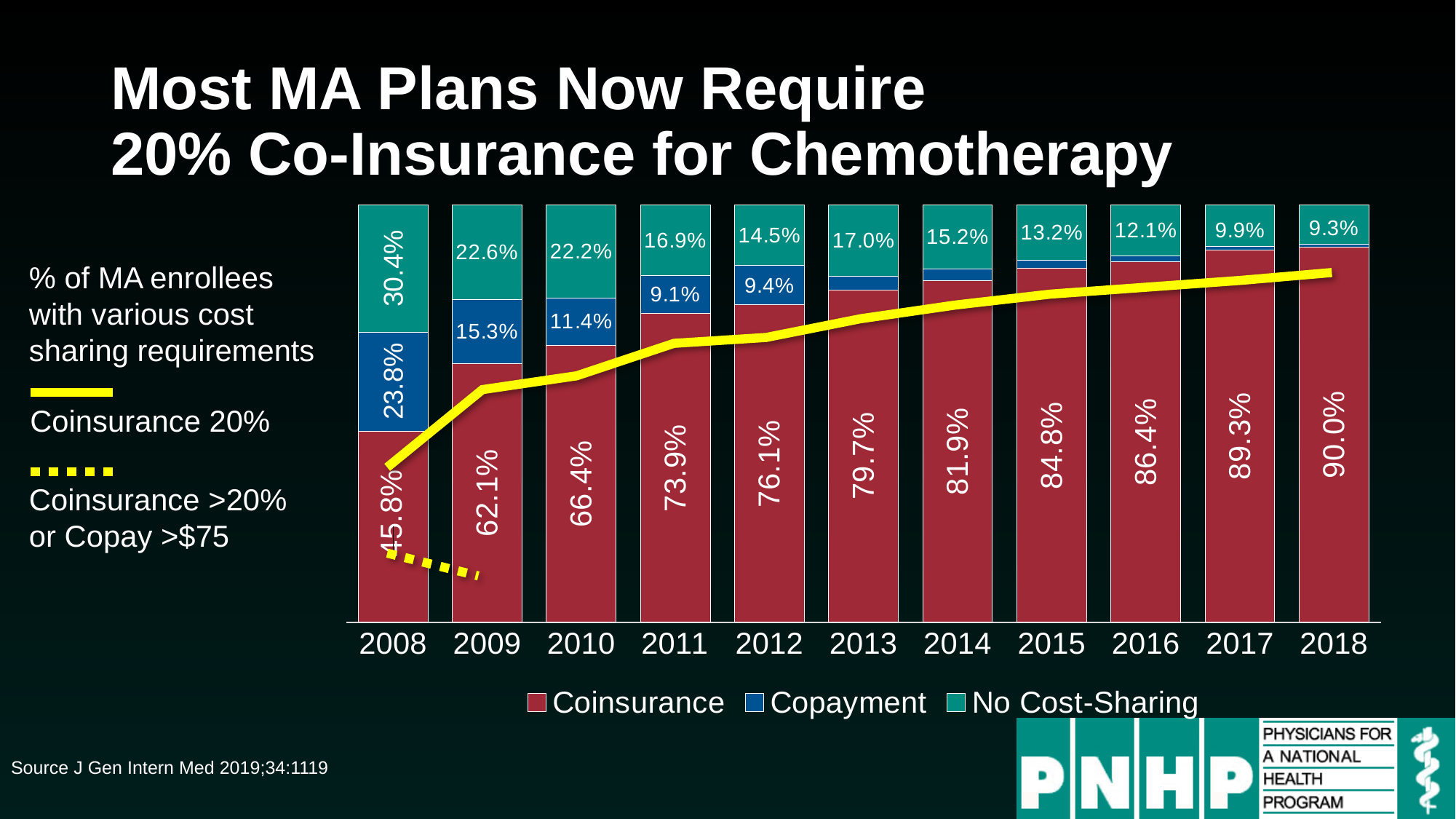
What is the Coinsurance value for 2008? 45.8% How many years are shown along the x axis? 11 Which series is shown in red in the legend? Coinsurance What is the Copayment value for 2010? 11.4% Which year has the lowest No Cost-Sharing value? 2018 Does the Coinsurance value rise or fall from 2008 to 2018? rise What is the No Cost-Sharing value for 2013? 17.0% Which is larger, the Copayment value for 2009 or the Copayment value for 2011? 2009 Which year has the highest Coinsurance value? 2018 How many series does the legend list? 3 What kind of chart is shown on the slide? stacked bar chart What is the difference between the Coinsurance values for 2018 and 2008? 44.2%